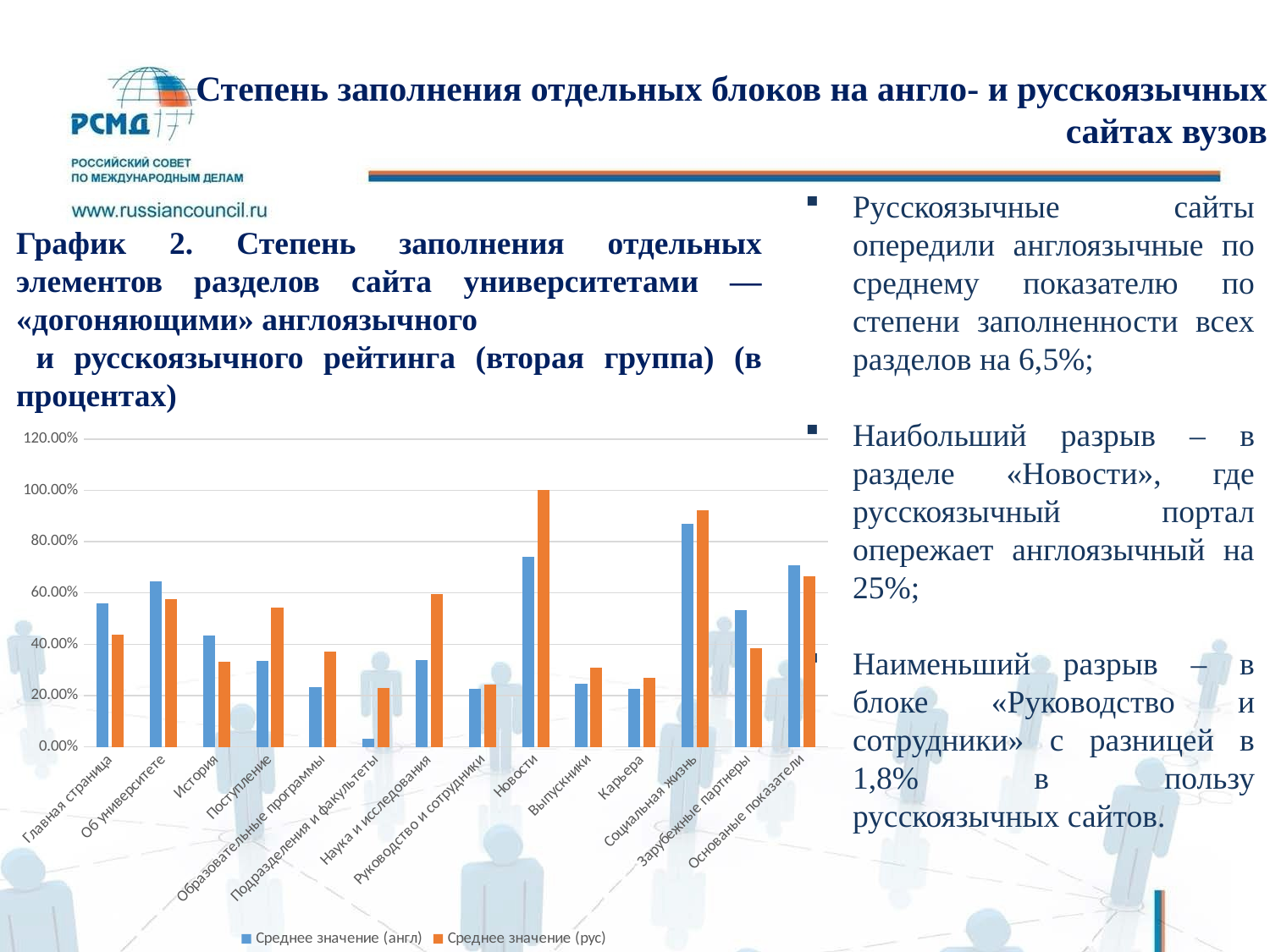
What colour are the bars for the series 'Среднее значение (рус)'? orange How many series does the chart legend list? 2 How many categories are shown along the x axis of the chart? 14 What kind of chart is shown on the slide? bar chart Is the value of 'Среднее значение (англ)' for 'Подразделения и факультеты' greater or less than 20.00%? less For the category 'Главная страница', which series has the larger value: 'Среднее значение (англ)' or 'Среднее значение (рус)'? Среднее значение (англ) Which category has the highest value for the series 'Среднее значение (англ)'? Социальная жизнь Is the value of 'Среднее значение (рус)' for 'Подразделения и факультеты' greater or less than 40.00%? less Which category has the lowest value for the series 'Среднее значение (англ)'? Подразделения и факультеты For the category 'Новости', which series has the larger value: 'Среднее значение (англ)' or 'Среднее значение (рус)'? Среднее значение (рус) Which category has the highest value for the series 'Среднее значение (рус)'? Новости Is the value of 'Среднее значение (англ)' for 'Новости' greater or less than 60.00%? greater